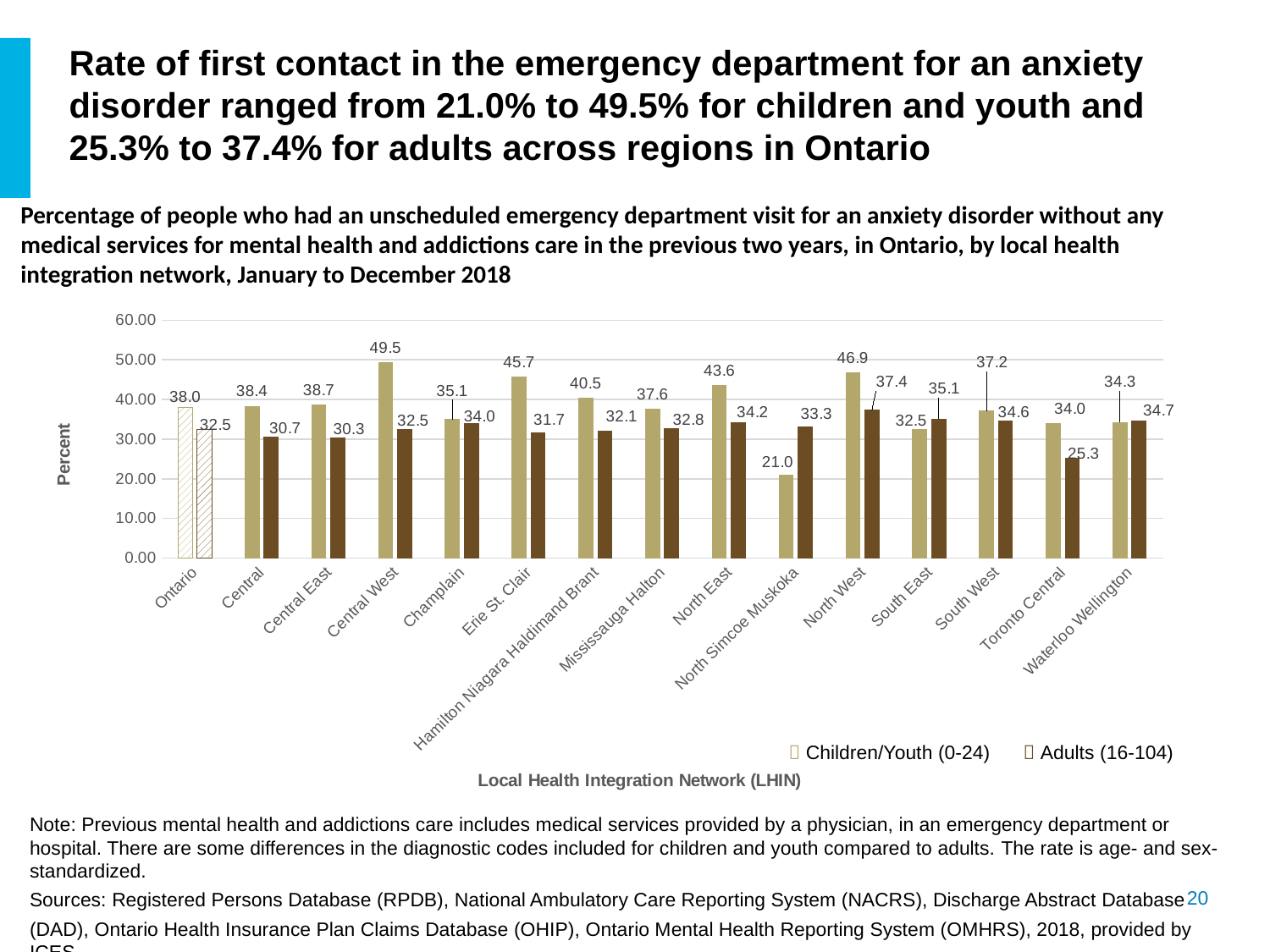
What kind of chart is shown on the slide? Bar chart Which LHIN has the lowest Adults (16-104) value? Toronto Central What is the label of the y axis? Percent How many series does the legend list? 2 What is the difference between the Children/Youth (0-24) and Adults (16-104) values for North West? 9.5 Which is larger for South East: the Children/Youth (0-24) value or the Adults (16-104) value? Adults (16-104) How many LHIN categories are shown on the x axis, including Ontario? 15 What is the Children/Youth (0-24) value for North Simcoe Muskoka? 21.0 What is the Children/Youth (0-24) value for Central West? 49.5 What is the Adults (16-104) value for Toronto Central? 25.3 Is the Children/Youth (0-24) value for Erie St. Clair greater or less than 40.00? greater Which LHIN has the highest Children/Youth (0-24) value? Central West